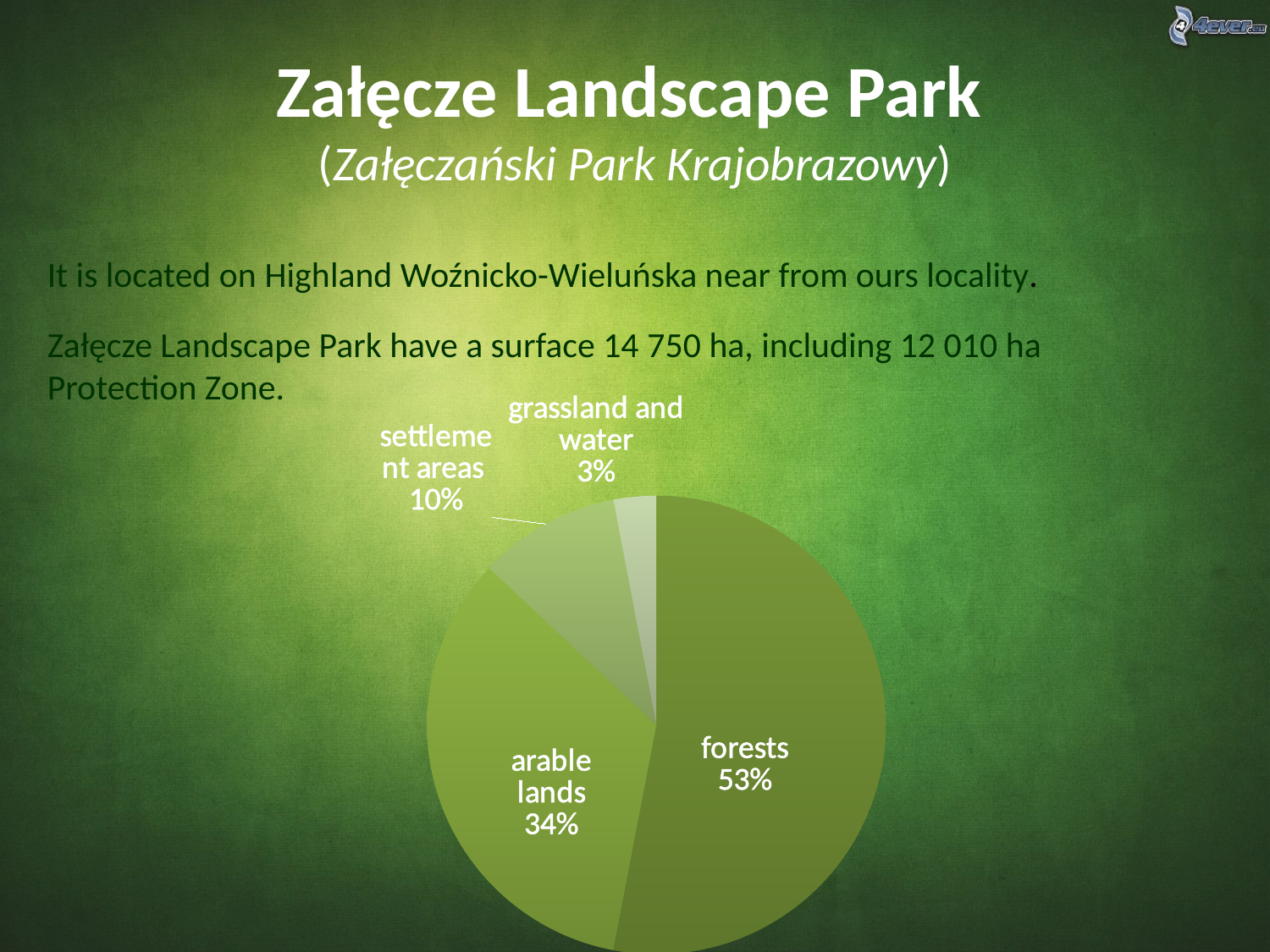
Which is larger in the pie chart, settlement areas or grassland and water? settlement areas What share of the pie chart is arable lands? 34% Which category has the smallest slice of the pie chart? grassland and water How many slices does the pie chart have? 4 Which category has the largest slice of the pie chart? forests What is the difference in percentage points between settlement areas and grassland and water? 7 What share of the pie chart is grassland and water? 3% What is the difference in percentage points between forests and arable lands? 19 Is the share for arable lands greater or less than 50%? less What kind of chart is shown on the slide? pie chart What share of the pie chart is forests? 53% What share of the pie chart is settlement areas? 10%